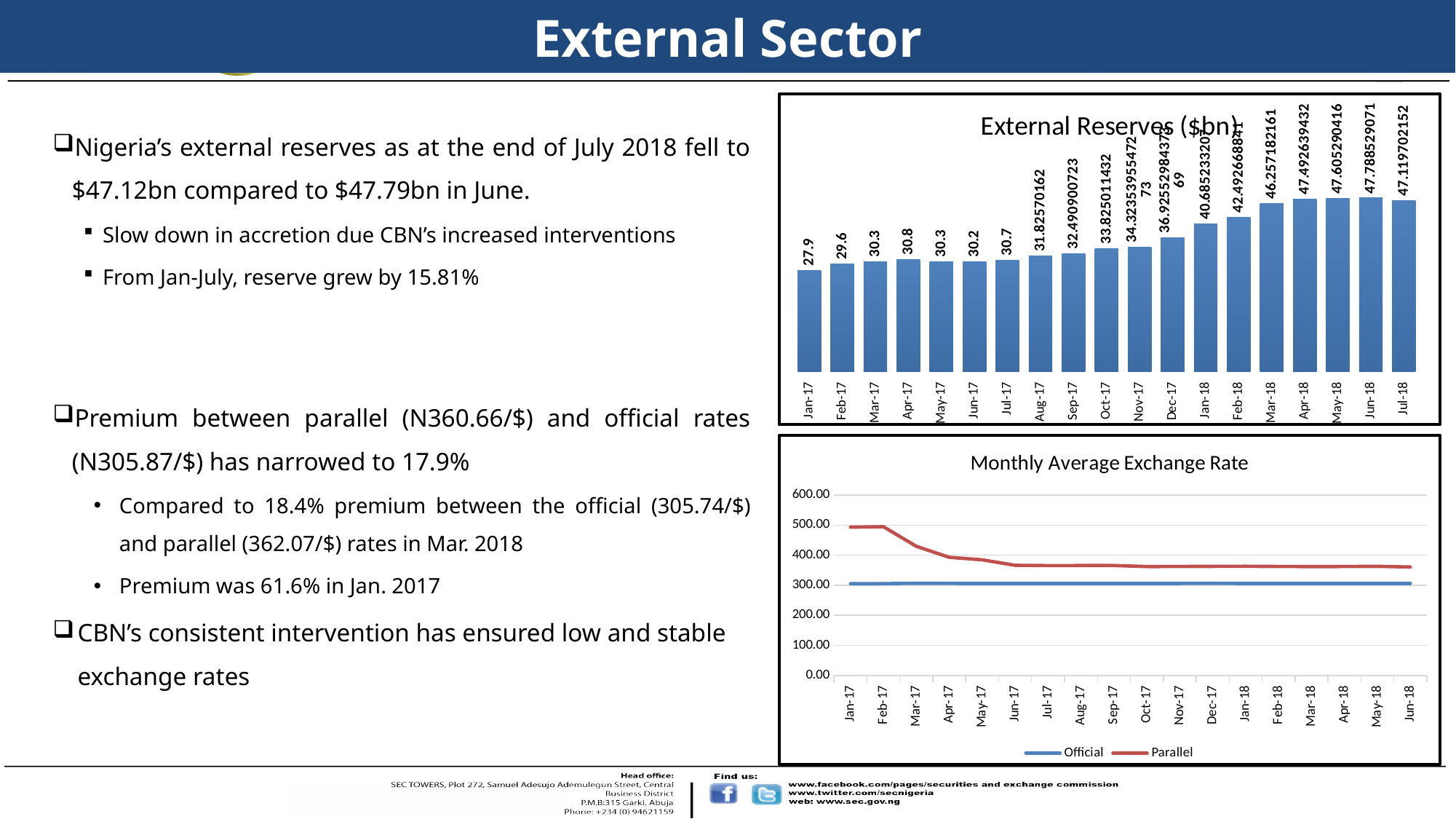
In the Monthly Average Exchange Rate chart, does the Parallel series rise or fall from Jan-17 to Jun-18? fall In the External Reserves ($bn) chart, which month has the highest value? Jun-18 In the External Reserves ($bn) chart, what is the value for Mar-18? 46.257182161 What kind of chart is the External Reserves ($bn) chart? bar chart In the External Reserves ($bn) chart, what is the difference between the values for Feb-17 and Jan-17? 1.7 In the External Reserves ($bn) chart, which is larger, the value for Apr-17 or May-17? Apr-17 How many series does the legend of the Monthly Average Exchange Rate chart list? 2 In the External Reserves ($bn) chart, which month has the lowest value? Jan-17 In the External Reserves ($bn) chart, how many bars are plotted? 19 In the Monthly Average Exchange Rate chart, is the Parallel value for Jan-17 greater or less than 400.00? greater In the External Reserves ($bn) chart, what is the value for Jan-17? 27.9 What kind of chart is the Monthly Average Exchange Rate chart? line chart